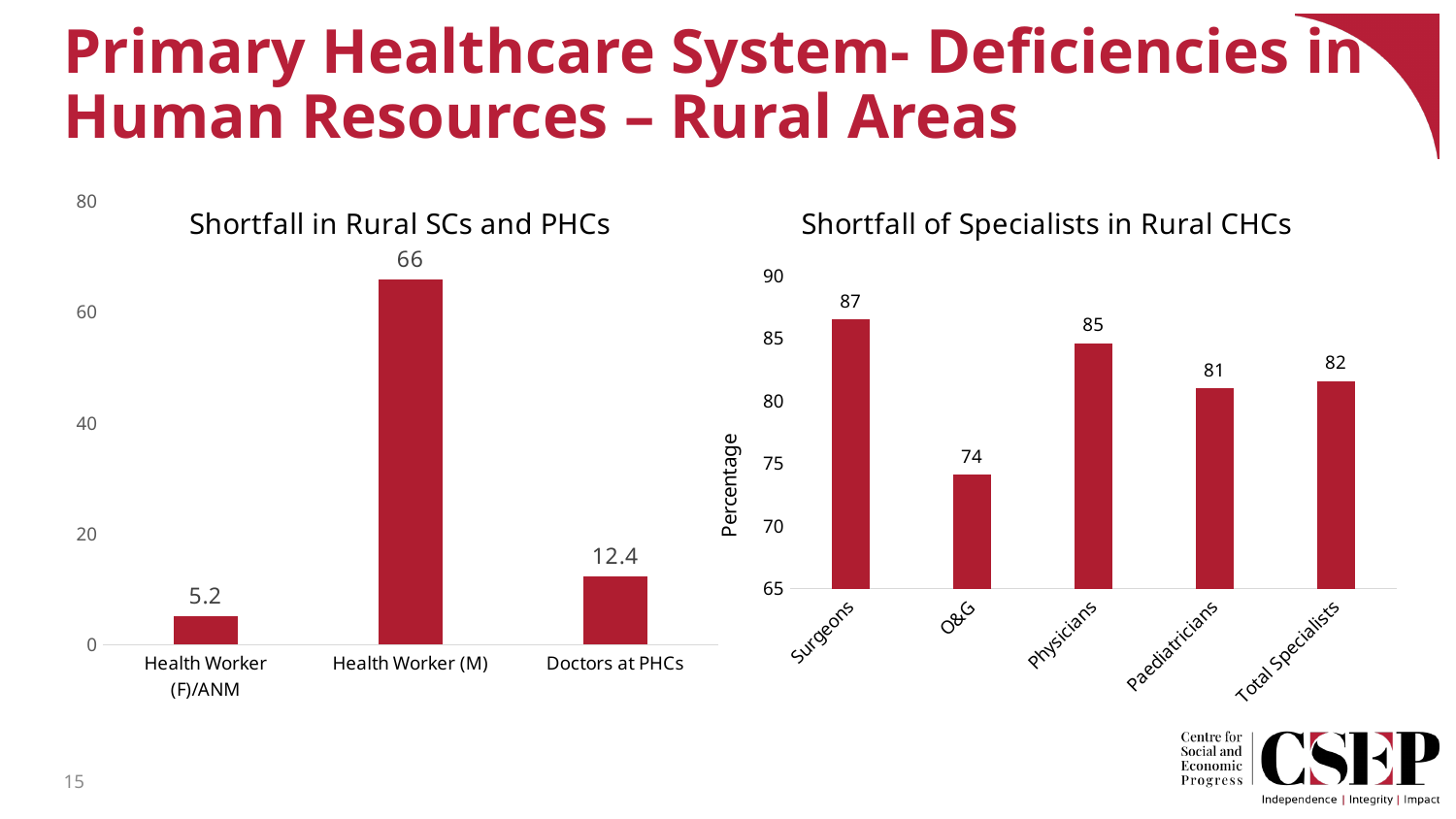
In the 'Shortfall in Rural SCs and PHCs' chart, what is the value for Health Worker (M)? 66 In the 'Shortfall in Rural SCs and PHCs' chart, how many categories are shown? 3 In the 'Shortfall of Specialists in Rural CHCs' chart, which is larger, Physicians or Total Specialists? Physicians In the 'Shortfall in Rural SCs and PHCs' chart, what is the difference between Health Worker (M) and Doctors at PHCs? 53.6 In the 'Shortfall of Specialists in Rural CHCs' chart, how many categories are shown? 5 In the 'Shortfall in Rural SCs and PHCs' chart, which category has the lowest value? Health Worker (F)/ANM In the 'Shortfall of Specialists in Rural CHCs' chart, what is the value for O&G? 74 What kind of chart is the 'Shortfall of Specialists in Rural CHCs' chart? Bar chart In the 'Shortfall of Specialists in Rural CHCs' chart, which category has the highest value? Surgeons In the 'Shortfall in Rural SCs and PHCs' chart, what is the value for Doctors at PHCs? 12.4 In the 'Shortfall of Specialists in Rural CHCs' chart, what is the difference between Surgeons and O&G? 13 In the 'Shortfall of Specialists in Rural CHCs' chart, what is the value for Paediatricians? 81